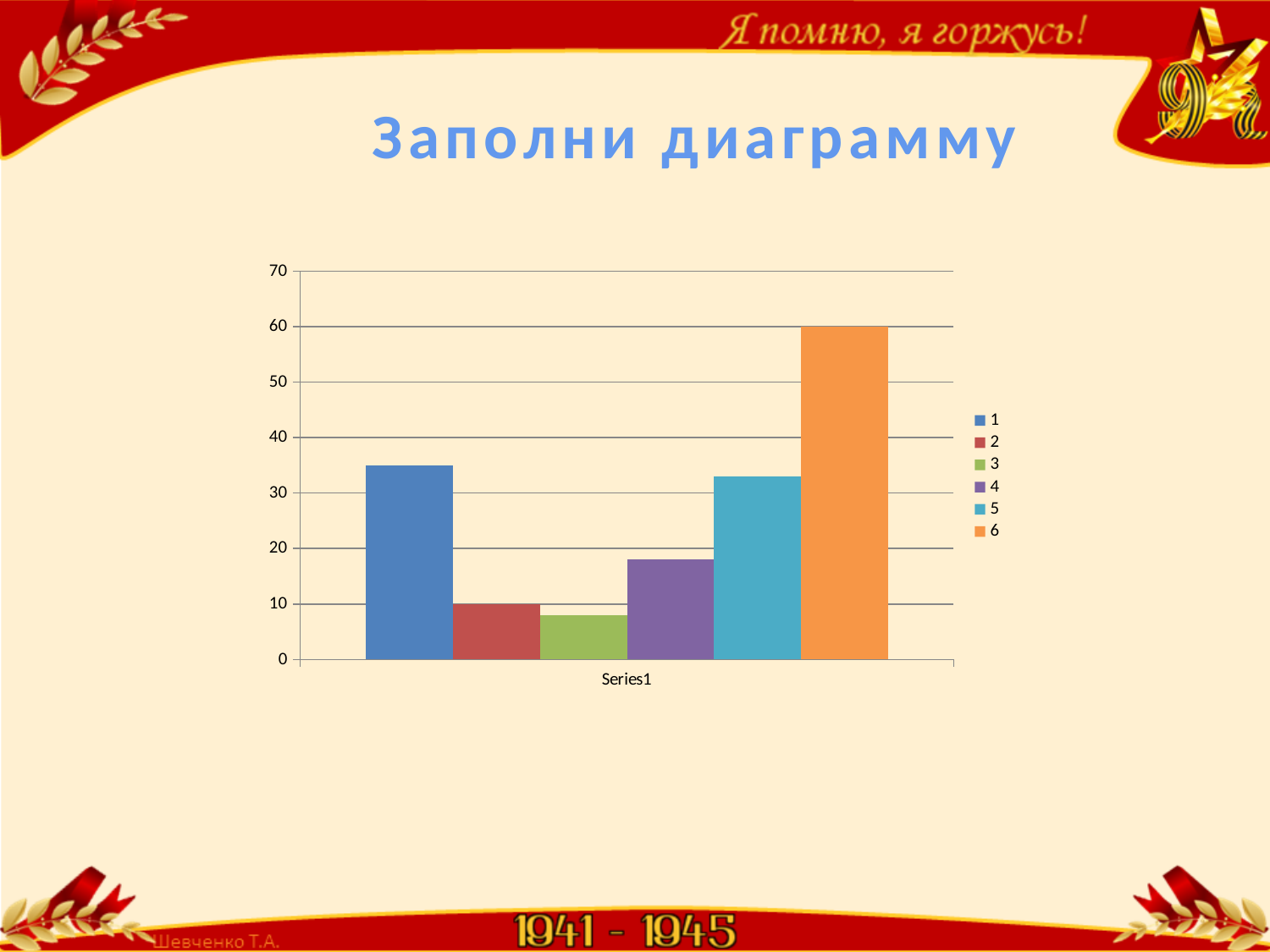
Is the value for series 1 greater or less than 30? greater Which is larger, the bar for series 4 or the bar for series 3? series 4 What is the value of the bar for series 2? 10 What is the value of the bar for series 6? 60 How many categories are shown on the x axis? 1 What is the title of the slide above the chart? Заполни диаграмму Is the value for series 4 greater or less than 20? less What kind of chart is shown on the slide? bar chart Which series has the highest bar? 6 Which series has the lowest bar? 3 How many series does the legend list? 6 Is the value for series 5 greater or less than 40? less